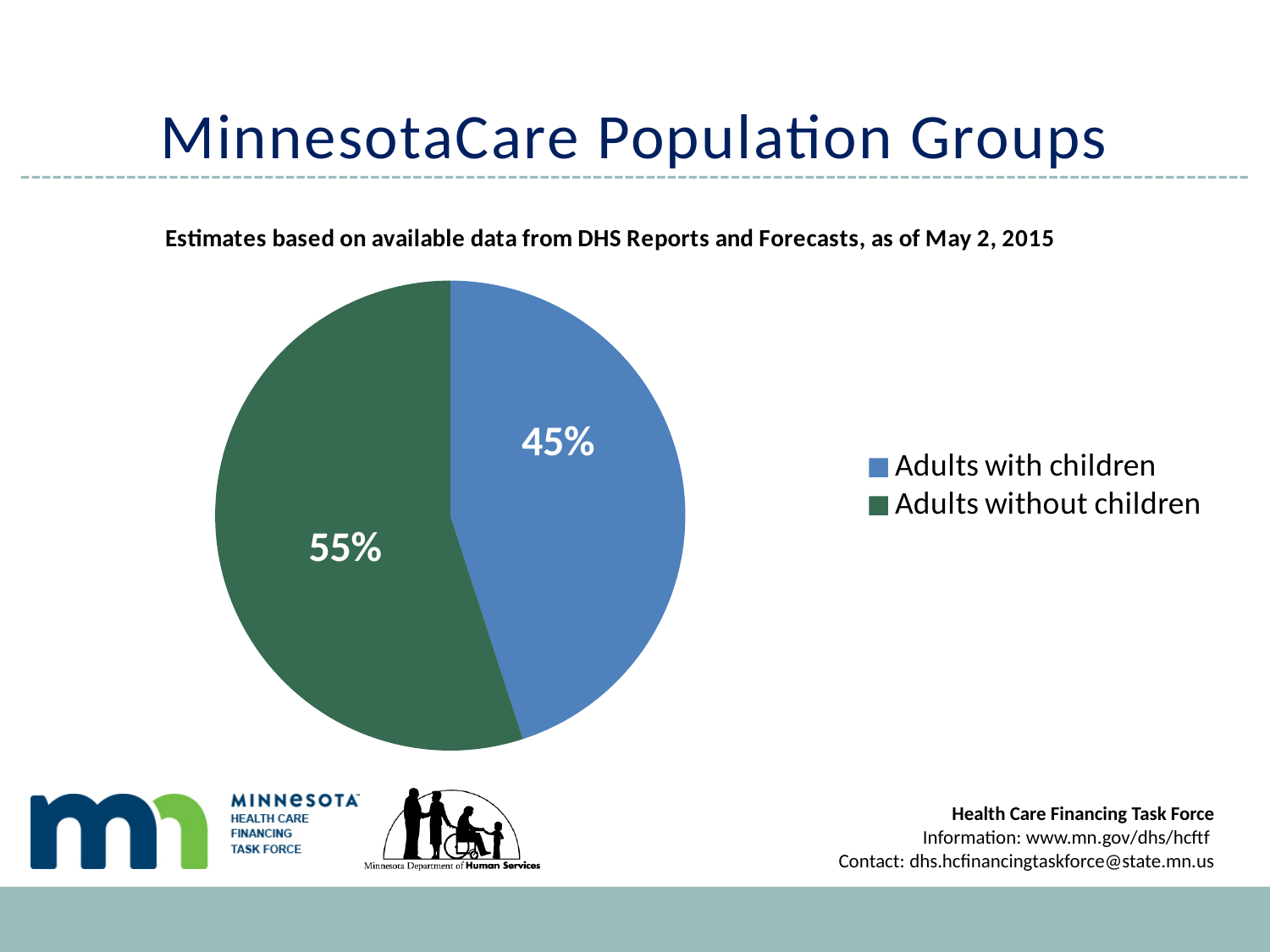
What share of the pie is labelled for Adults without children? 55% What kind of chart is shown on the slide? Pie chart How many entries does the legend list? 2 What share of the pie is labelled for Adults with children? 45% What is the title of the slide containing the chart? MinnesotaCare Population Groups Which population group has the largest share of the pie? Adults without children Which slice is larger: Adults with children or Adults without children? Adults without children How many slices does the pie chart have? 2 Which population group has the smallest share of the pie? Adults with children What is the difference in percentage points between the Adults without children slice and the Adults with children slice? 10 What colour is the slice for Adults without children? Green